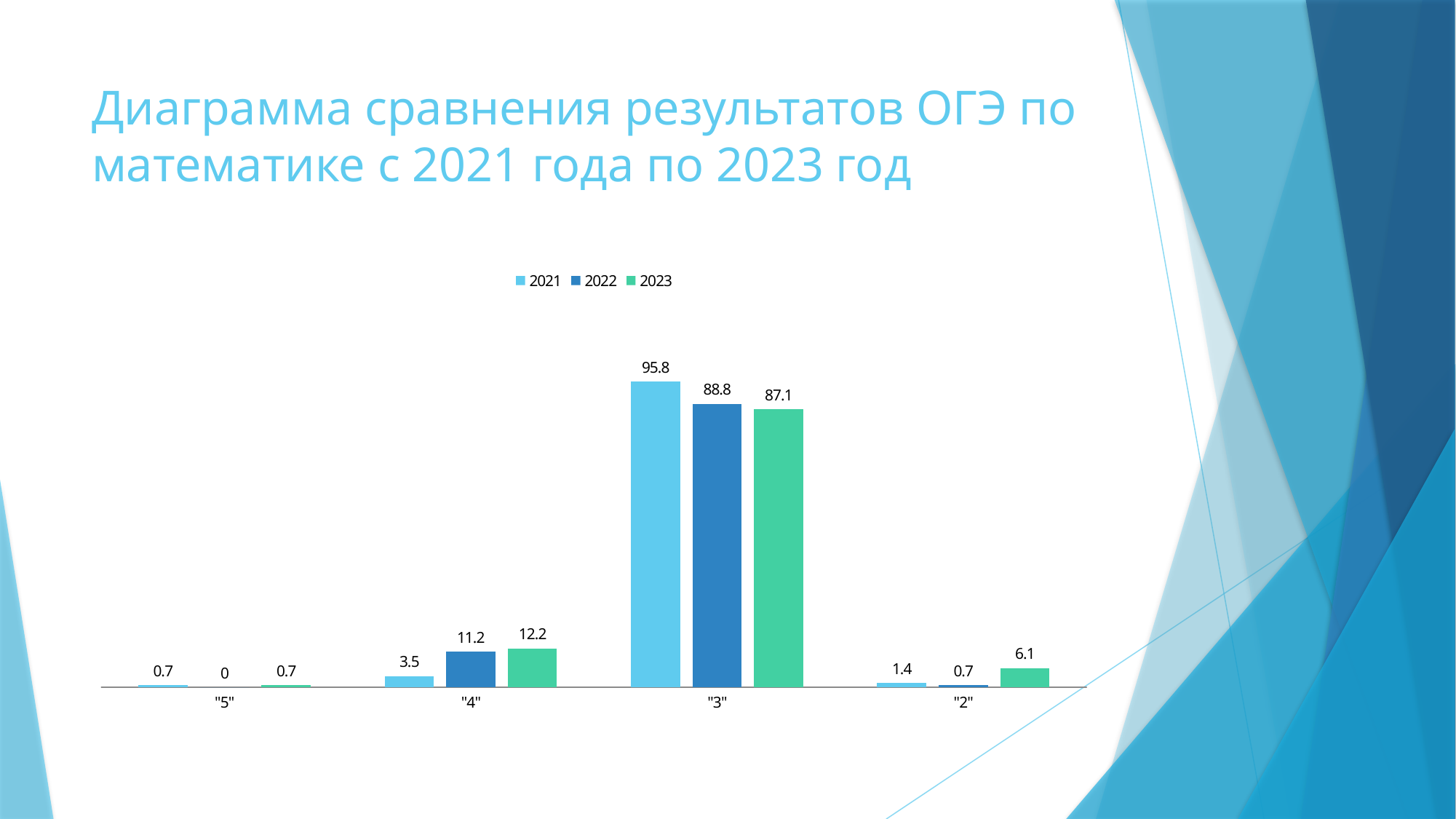
Which is larger for "2": the 2021 value or the 2023 value? 2023 Which category has the highest value in the 2023 series? "3" Which category has the lowest value in the 2022 series? "5" What is the value for "4" in the 2023 series? 12.2 What is the difference between the 2021 and 2023 values for "3"? 8.7 What are the series names listed in the legend? 2021, 2022, 2023 How many categories are shown on the x axis? 4 What is the value for "5" in the 2022 series? 0 What kind of chart is shown on the slide? Bar chart What is the value for "2" in the 2022 series? 0.7 What is the value for "3" in the 2021 series? 95.8 How many series does the legend list? 3